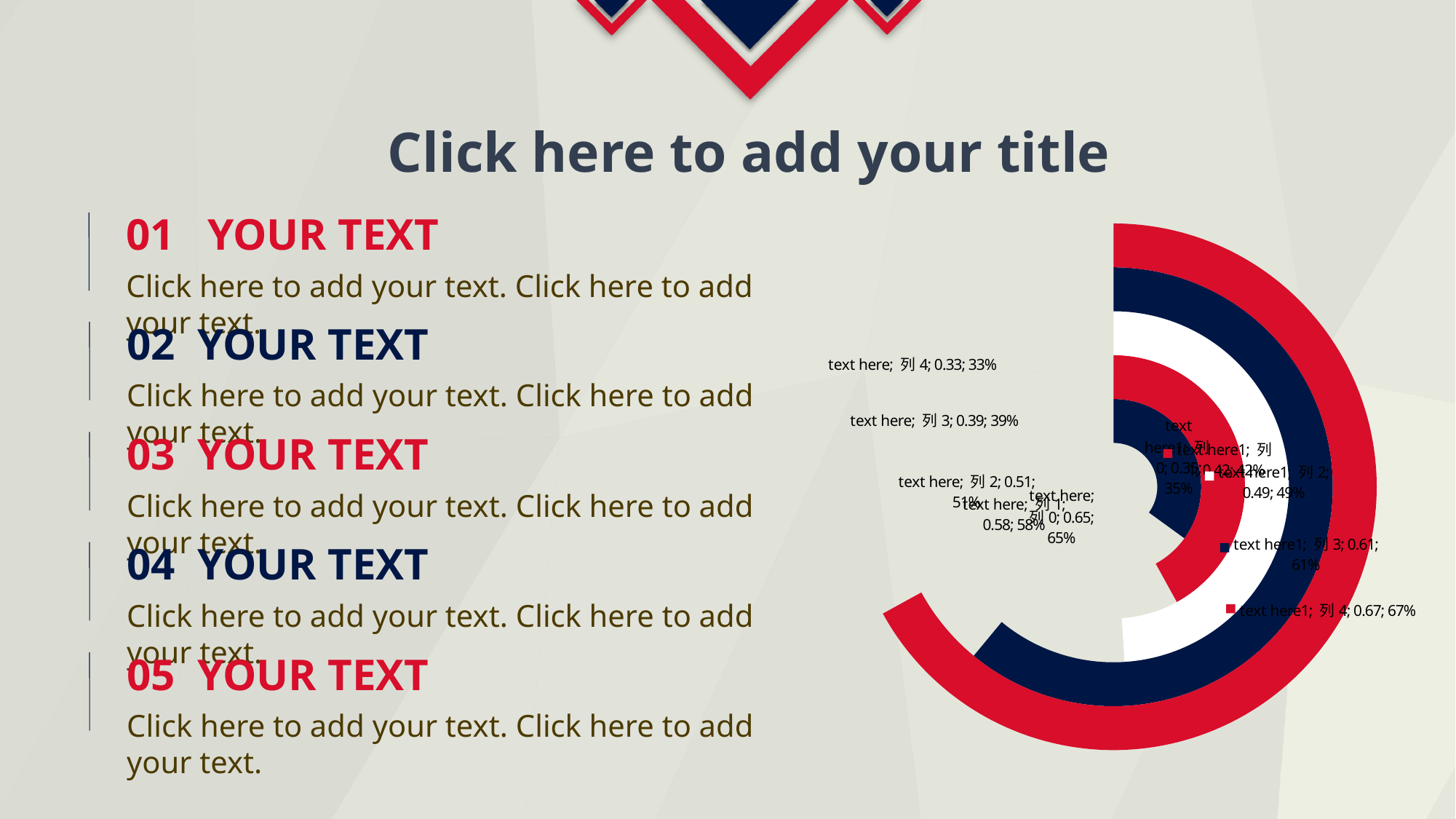
What percentage is shown in the data label for 列 2 in the "text here" series? 51% What is the difference between the values for 列 4 and 列 3 in the "text here1" series? 0.06 In the "text here" series, which is larger: 列 2 or 列 3? 列 2 What is the value for 列 3 in the "text here" series? 0.39 Which category has the highest value in the "text here" series? 列 0 What is the value for 列 0 in the "text here" series? 0.65 Which category has the lowest value in the "text here" series? 列 4 What kind of chart is shown on the right of the slide? doughnut chart What is the value for 列 4 in the "text here1" series? 0.67 How many categories (列) does the chart plot? 5 What is the value for 列 4 in the "text here" series? 0.33 What is the value for 列 3 in the "text here1" series? 0.61